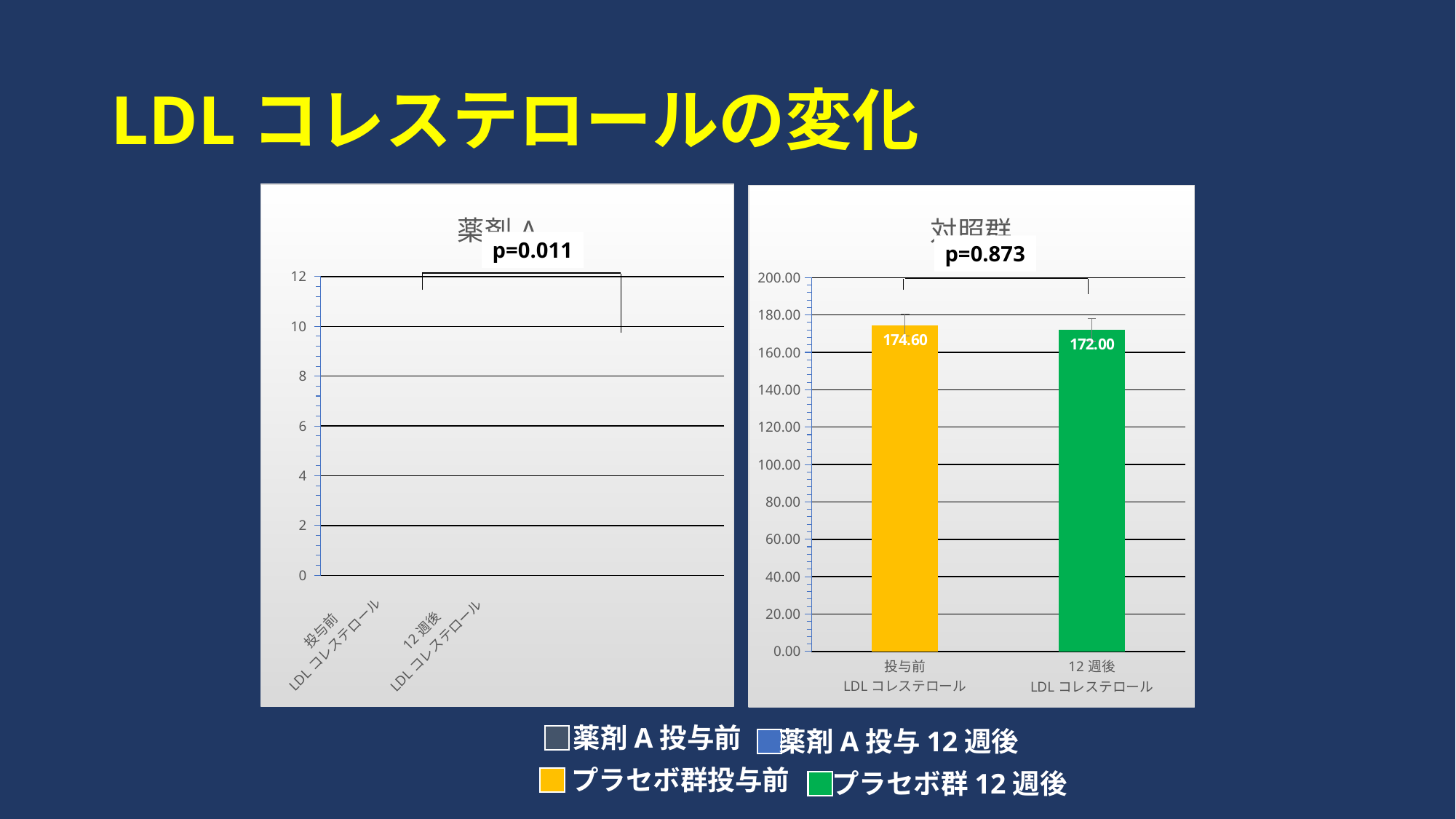
How many bars are plotted in the 対照群 chart? 2 In the 対照群 chart, which category has the higher value? 投与前 LDL コレステロール What kind of chart is the 対照群 chart? bar chart In the 対照群 chart, what is the value for 投与前 LDL コレステロール? 174.60 In the 対照群 chart, what is the difference between the 投与前 and 12 週後 values? 2.60 In the 対照群 chart, what is the value for 12 週後 LDL コレステロール? 172.00 In the 対照群 chart, which category has the lower value? 12 週後 LDL コレステロール What p-value is shown on the 薬剤A chart on the left? p=0.011 What p-value is shown on the 対照群 chart? p=0.873 In the 対照群 chart, is the value for 12 週後 LDL コレステロール greater or less than 180.00? less In the 対照群 chart, do the values rise or fall from 投与前 to 12 週後? fall In the 対照群 chart, is the value for 投与前 LDL コレステロール greater or less than 160.00? greater